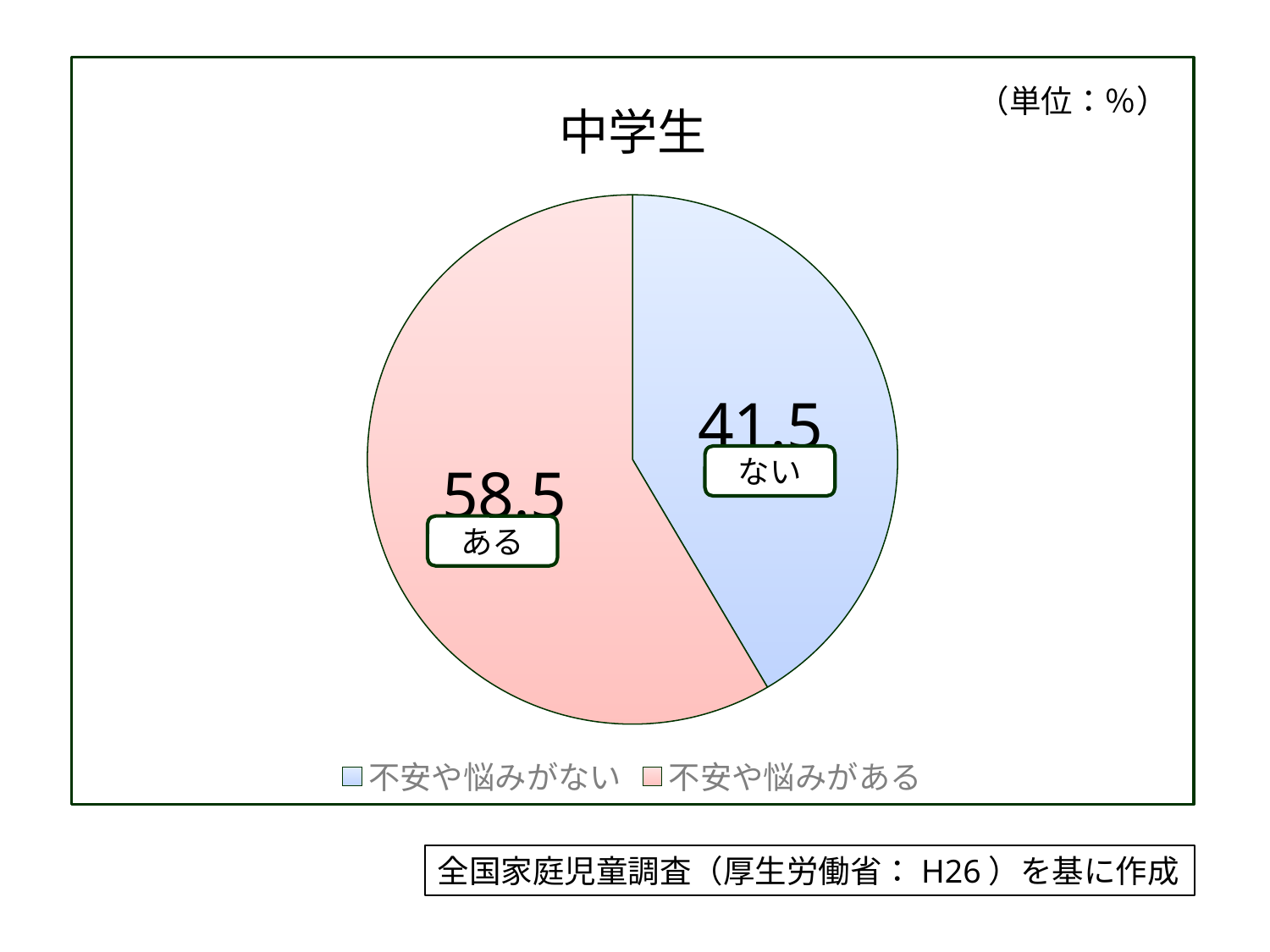
What unit is indicated for the values on the chart? % Which category has the largest slice? 不安や悩みがある What kind of chart is shown on the slide? pie chart How many entries does the legend list? 2 What share of the pie does the 不安や悩みがない slice represent? 41.5% What is the value for 不安や悩みがない? 41.5 How many slices does the pie chart have? 2 What is the title of the chart? 中学生 Which is larger, the value for 不安や悩みがある or 不安や悩みがない? 不安や悩みがある Which category has the smallest slice? 不安や悩みがない What is the value for 不安や悩みがある? 58.5 What is the difference between the values for 不安や悩みがある and 不安や悩みがない? 17